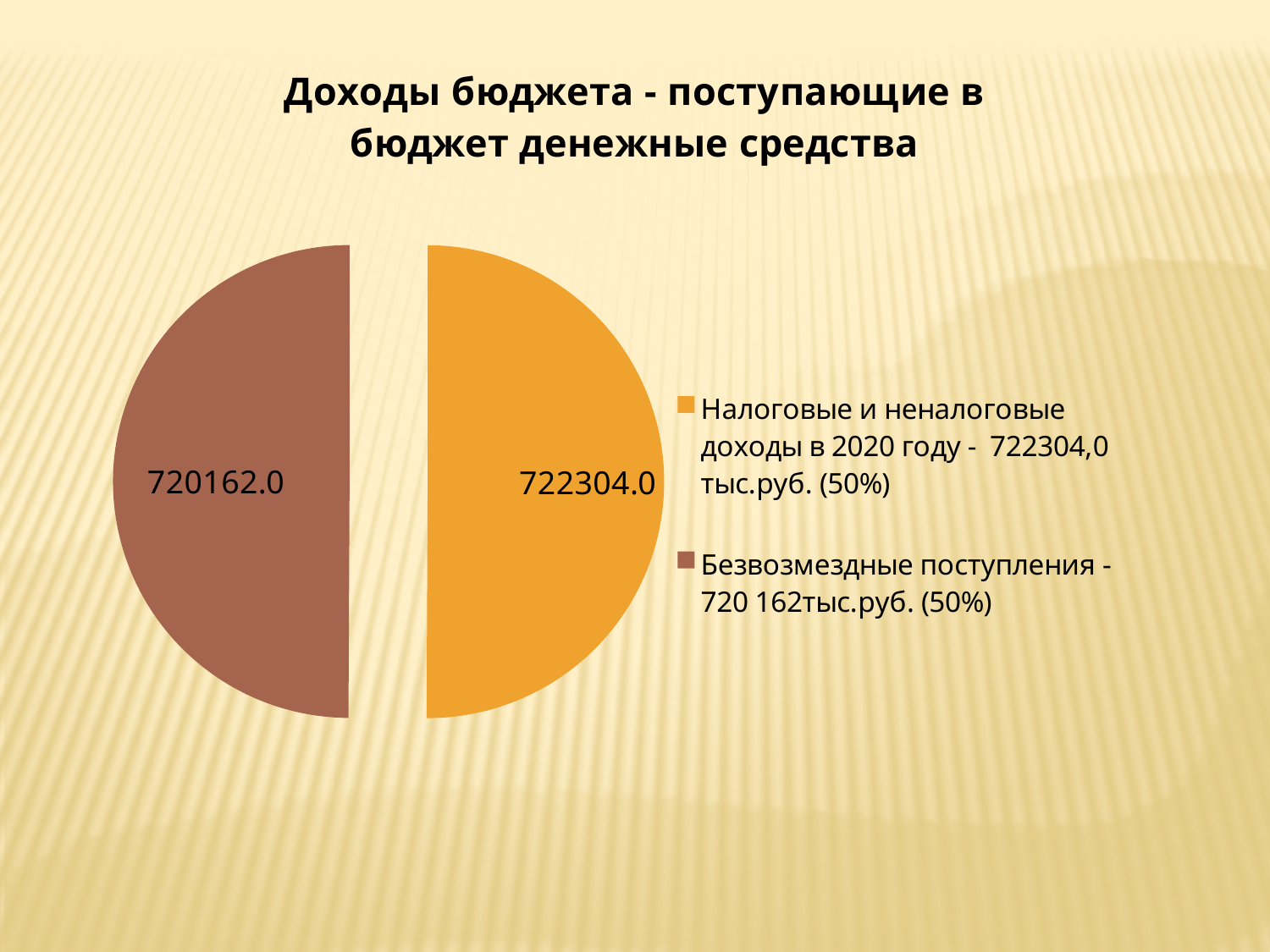
How many entries does the legend of the chart list? 2 What is the value for Налоговые и неналоговые доходы in the pie chart? 722304.0 What kind of chart is shown on the slide? pie chart Which slice has the larger value: Налоговые и неналоговые доходы or Безвозмездные поступления? Налоговые и неналоговые доходы What is the value for Безвозмездные поступления in the pie chart? 720162.0 How many slices does the pie chart have? 2 What is the difference between the values of the two slices in the pie chart? 2142.0 What is the title of the chart on the slide? Доходы бюджета - поступающие в бюджет денежные средства According to the legend, what share of the pie does Безвозмездные поступления represent? 50% What value is shown on the orange slice of the pie chart? 722304.0 What colour is the slice for Налоговые и неналоговые доходы in the pie chart? orange What value is shown on the brown slice of the pie chart? 720162.0